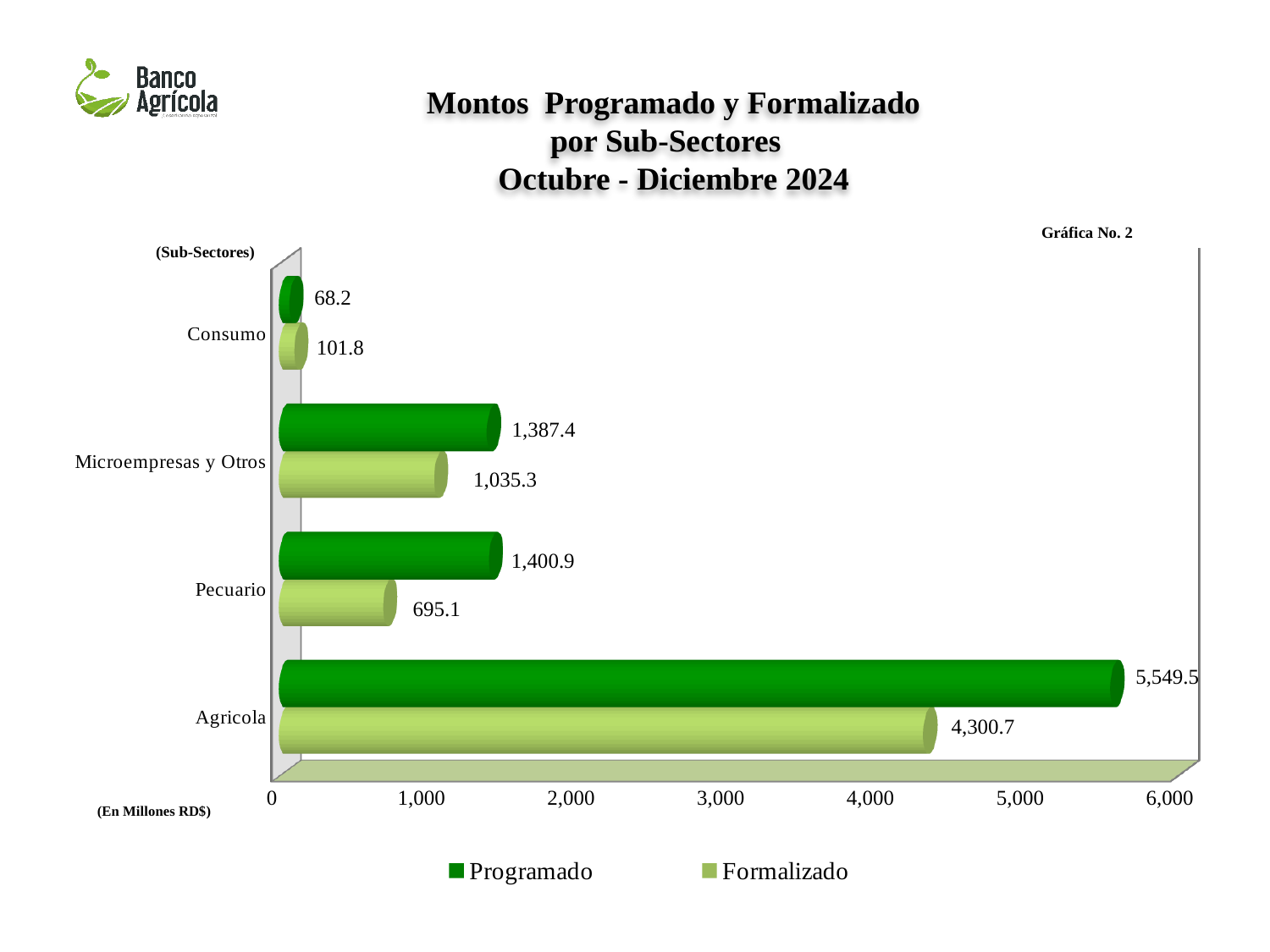
How many sub-sectors are shown on the chart? 4 What is the difference between the Programado and Formalizado values for Agricola? 1,248.8 Which sub-sector has the lowest Programado value? Consumo Which sub-sector has the highest Formalizado value? Agricola What is the Programado value for Consumo? 68.2 For Consumo, which is larger: the Programado value or the Formalizado value? Formalizado What is the Programado value for Agricola? 5,549.5 Is the Formalizado value for Agricola greater or less than 4,000? greater How many series does the legend list? 2 What is the Formalizado value for Pecuario? 695.1 What is the Formalizado value for Microempresas y Otros? 1,035.3 What is the difference between the Programado and Formalizado values for Pecuario? 705.8